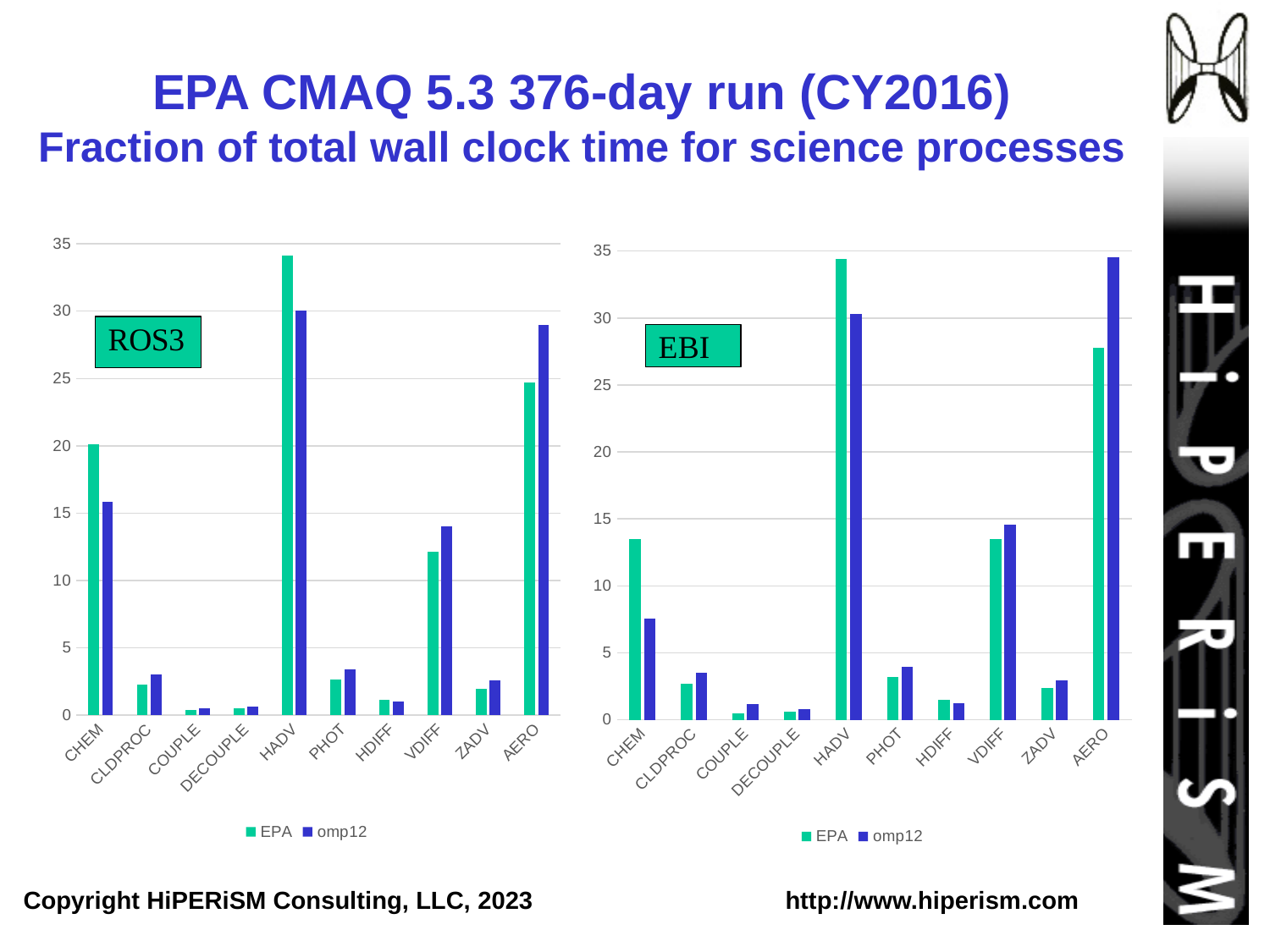
In the EBI chart, for AERO, which series has the larger value, EPA or omp12? omp12 In the EBI chart, which category has the highest omp12 value? AERO What are the two series named in the legend of the EBI chart? EPA and omp12 In the ROS3 chart, is the EPA value for HADV greater or less than 30? greater In the ROS3 chart, which category has the highest EPA value? HADV How many series does the legend of the ROS3 chart list? 2 In the EBI chart, is the omp12 value for CHEM greater or less than 10? less How many categories are shown on the x axis of the EBI chart? 10 In the ROS3 chart, for CHEM, which series has the larger value, EPA or omp12? EPA In the ROS3 chart, is the omp12 value for AERO greater or less than 25? greater In the EBI chart, which category has the highest EPA value? HADV What kind of chart is the ROS3 chart on the left? Bar chart